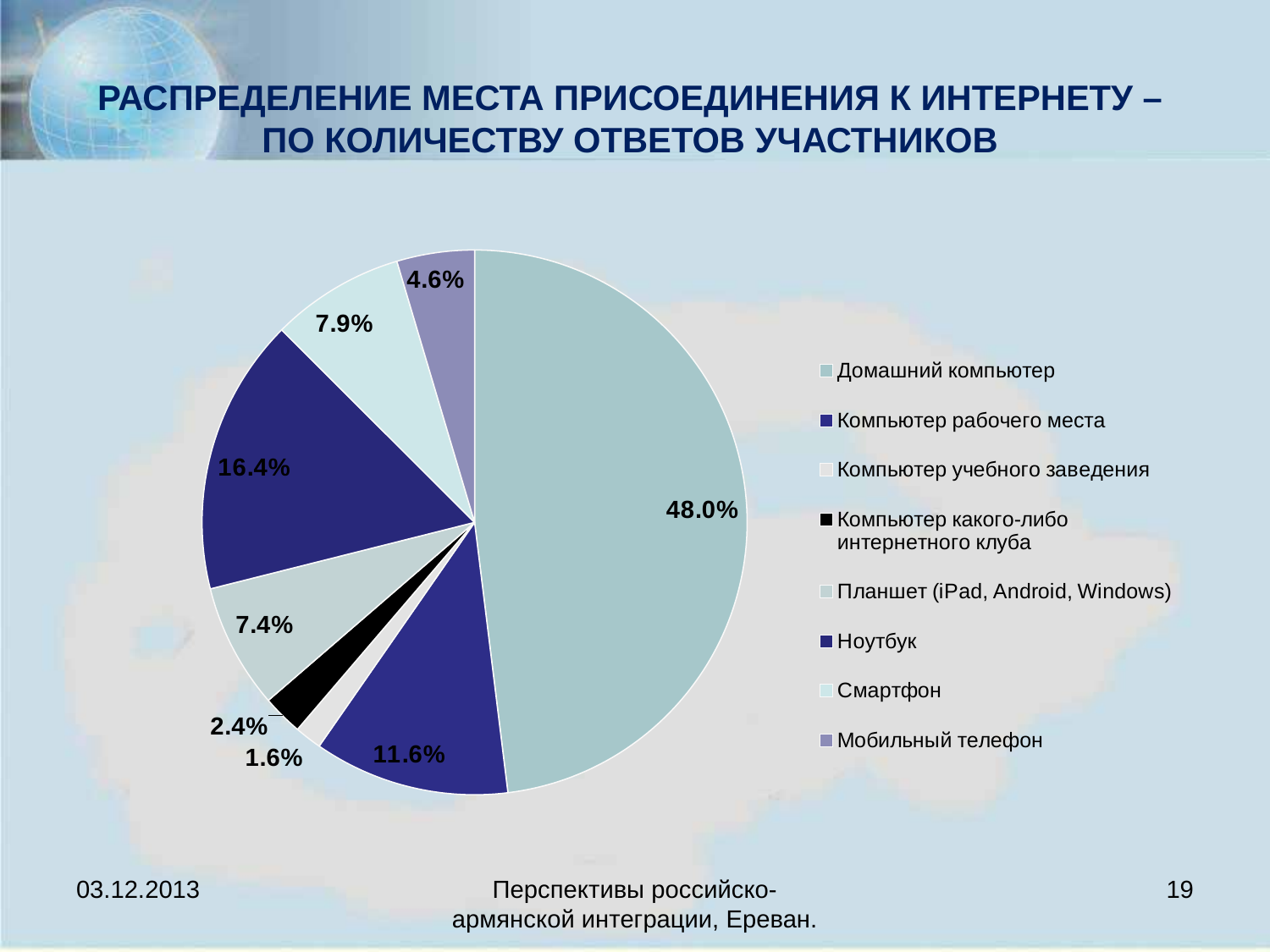
What share of responses is for Компьютер учебного заведения? 1.6% How many categories does the legend list? 8 Which category has the largest share of the pie? Домашний компьютер What share of responses is for Компьютер рабочего места? 11.6% What share of responses is for Смартфон? 7.9% What share of responses is for Домашний компьютер? 48.0% What share of responses is for Ноутбук? 16.4% What is the difference in percentage points between Ноутбук and Планшет (iPad, Android, Windows)? 9.0 What type of chart is shown on the slide? pie chart What share of responses is for Мобильный телефон? 4.6% Which category has the smallest share of the pie? Компьютер учебного заведения Which is larger: the share for Смартфон or the share for Мобильный телефон? Смартфон